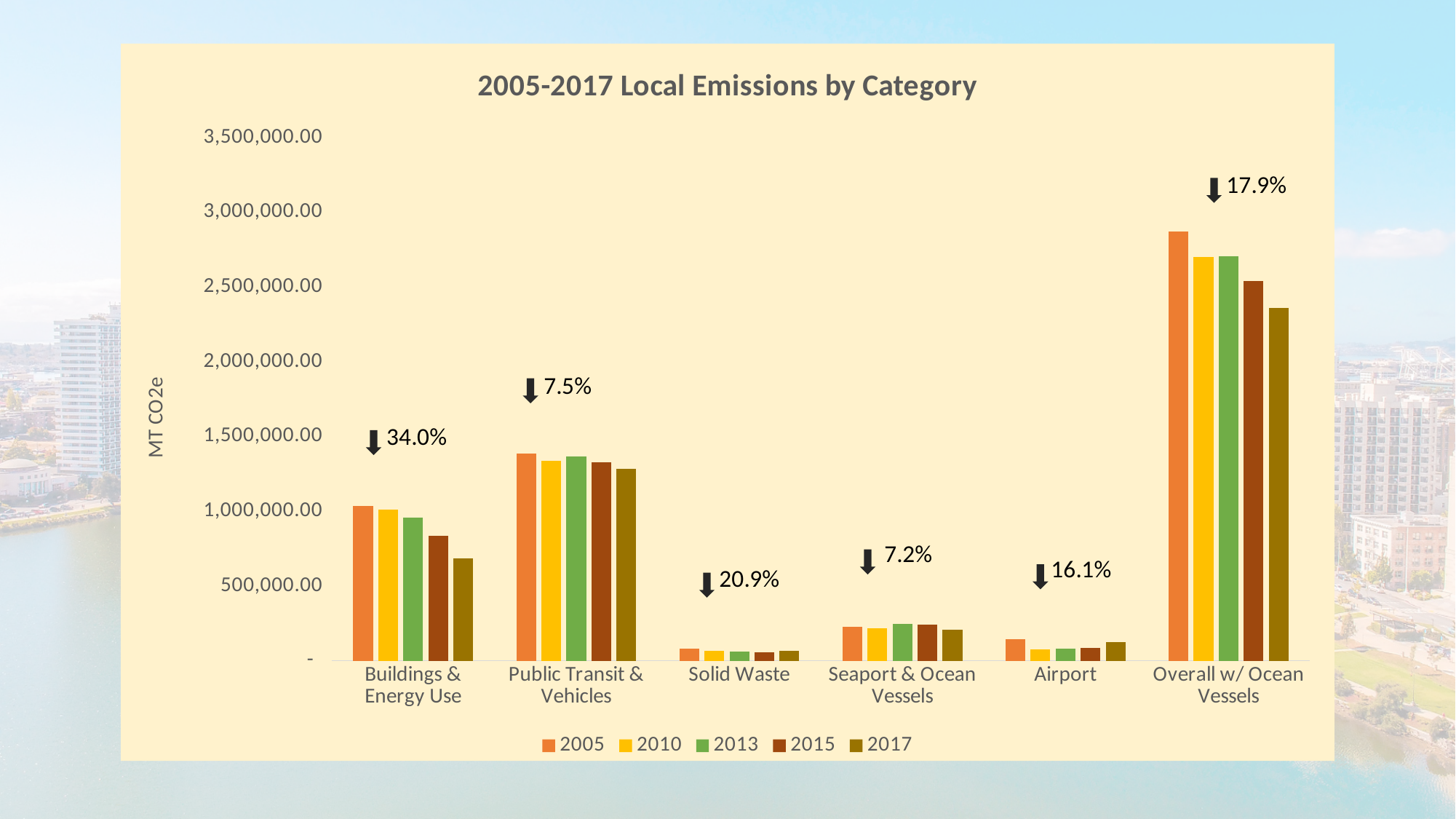
What percentage decrease is annotated above the Buildings & Energy Use category? 34.0% What percentage decrease is annotated above the Solid Waste category? 20.9% Which category has the largest annotated percentage decrease? Buildings & Energy Use What is the label on the vertical axis of the chart? MT CO2e How many series does the legend list? 5 Which category has the tallest bars in the chart? Overall w/ Ocean Vessels Is the 2005 value for Overall w/ Ocean Vessels greater or less than 2,500,000.00? greater Do the bars for Buildings & Energy Use rise or fall from 2005 to 2017? fall What kind of chart is shown on the slide? bar chart How many categories are shown on the x axis of the chart? 6 What is the title of the chart? 2005-2017 Local Emissions by Category What percentage decrease is annotated above the Airport category? 16.1%